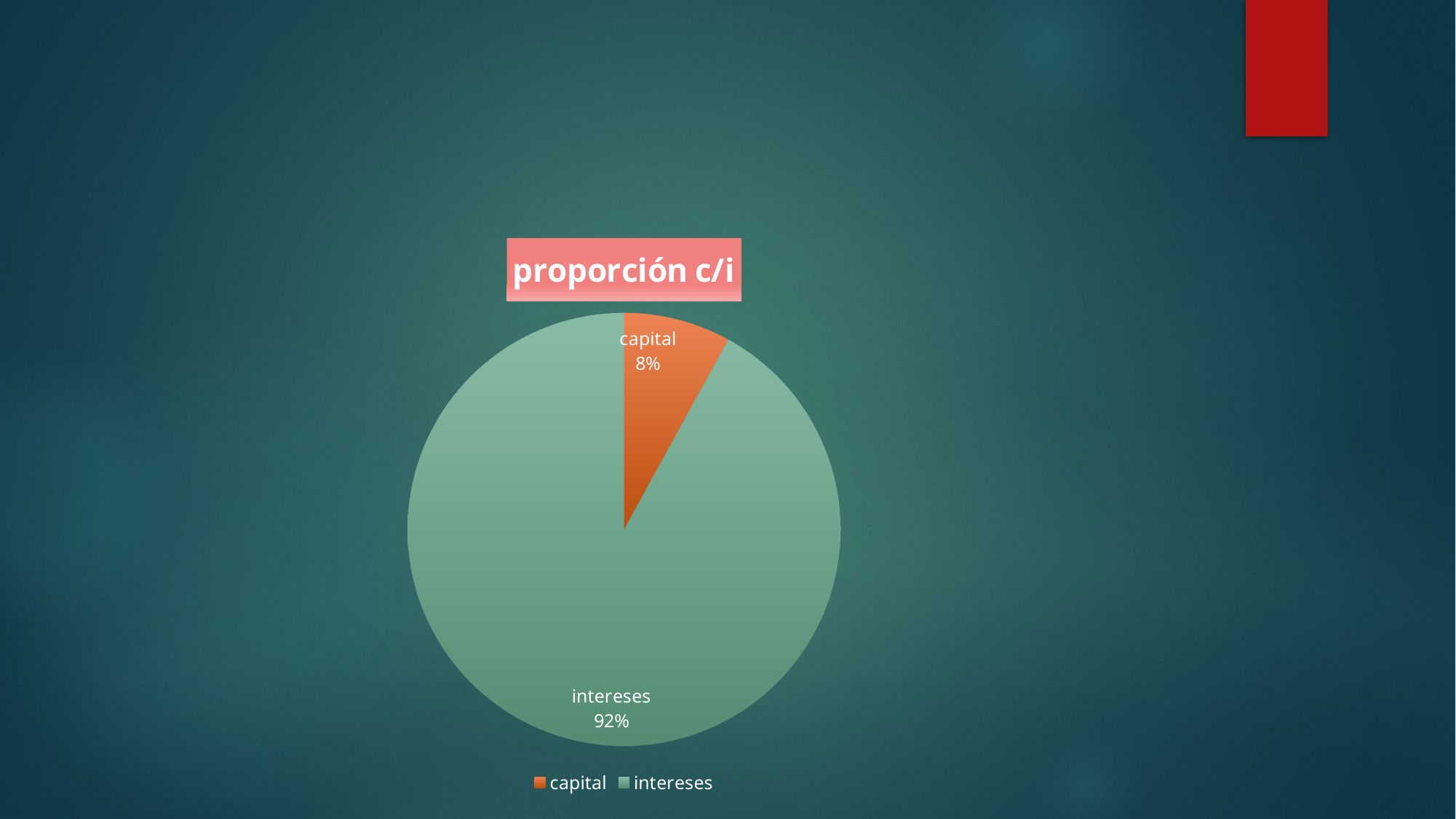
Which slice is the largest? intereses What share of the pie does intereses represent? 92% Which is larger, capital or intereses? intereses What colour is the capital slice? orange How many entries does the legend list? 2 What share of the pie does capital represent? 8% What is the difference in percentage points between intereses and capital? 84 What is the title of the chart? proporción c/i How many slices does the pie chart have? 2 What kind of chart is shown on the slide? pie chart Which slice is the smallest? capital